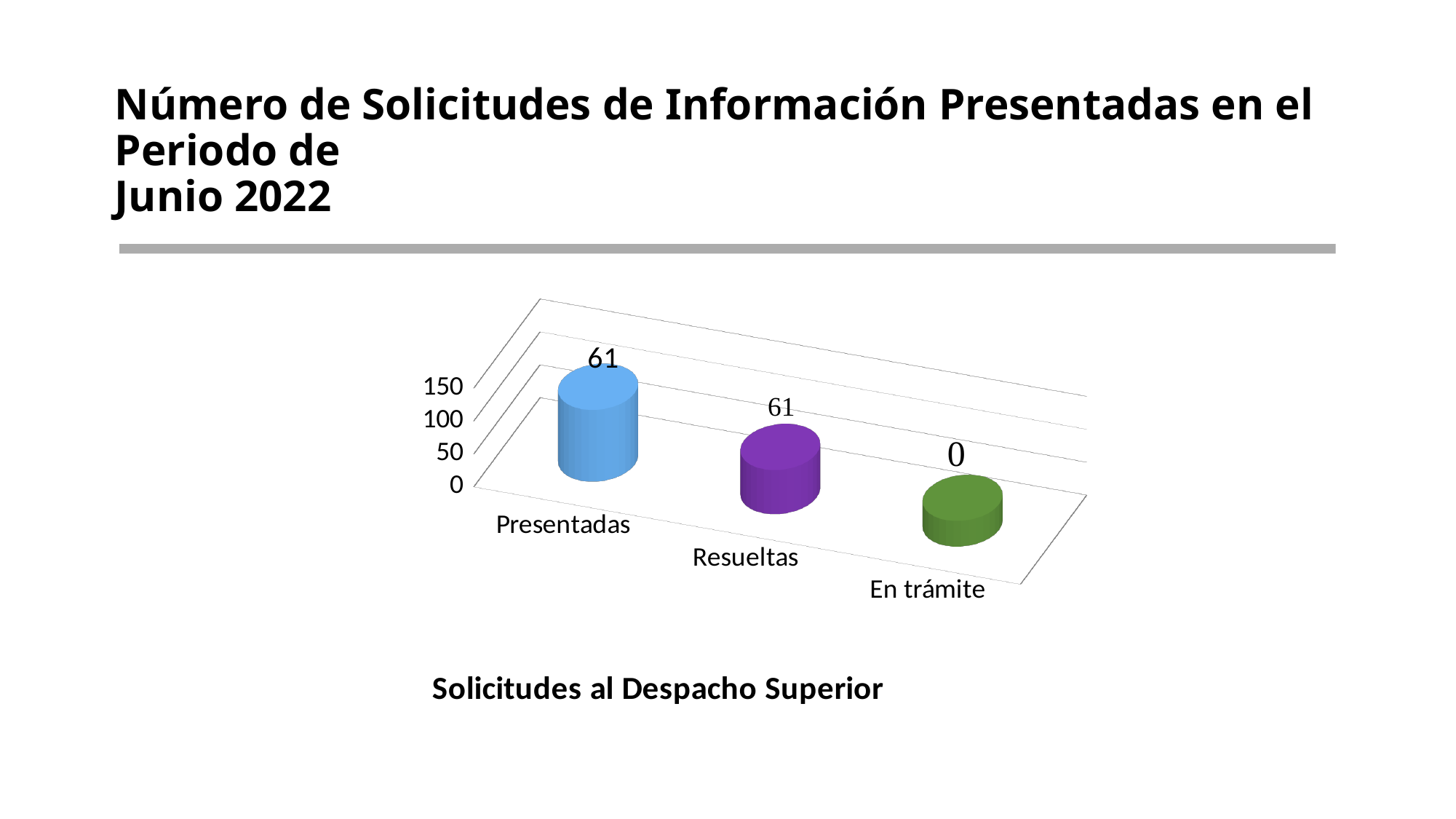
Which is larger, the value for Resueltas or the value for En trámite? Resueltas What is the chart's title shown below the plot? Solicitudes al Despacho Superior How many categories are shown on the chart? 3 What colour is the bar for Resueltas? purple Which category has the lowest value? En trámite What kind of chart is shown on the slide? bar chart